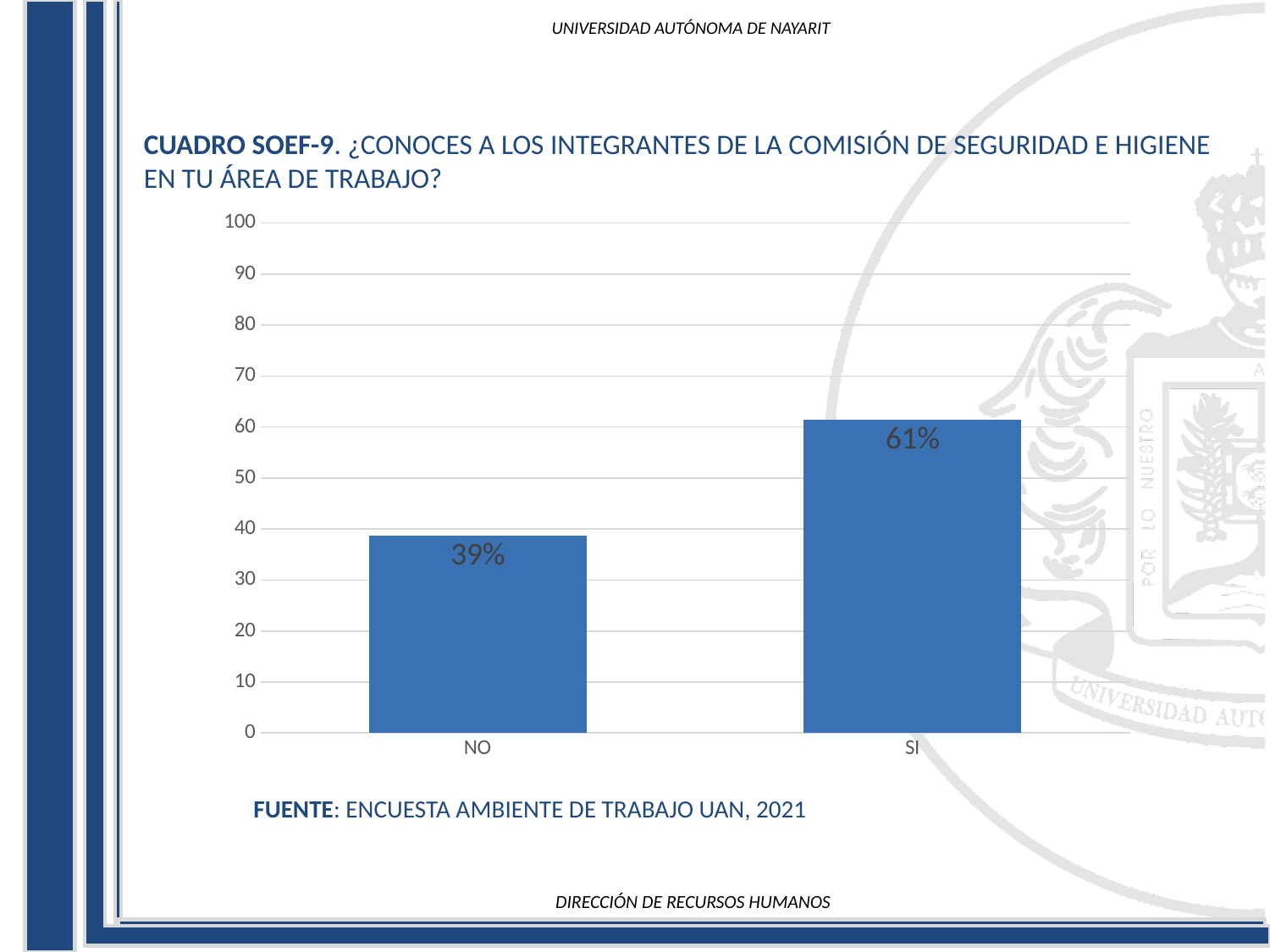
What is the maximum value shown on the y axis? 100 Is the value for NO greater or less than 50? less How many categories are shown on the x axis? 2 Is the value for SI greater or less than 50? greater What is the difference between the values for SI and NO? 22% What is the value for SI? 61% What kind of chart is shown on the slide? bar chart Which is larger, the value for NO or the value for SI? SI Which category has the lowest value? NO What is the value for NO? 39% Which category has the highest value? SI What source is cited below the chart? ENCUESTA AMBIENTE DE TRABAJO UAN, 2021